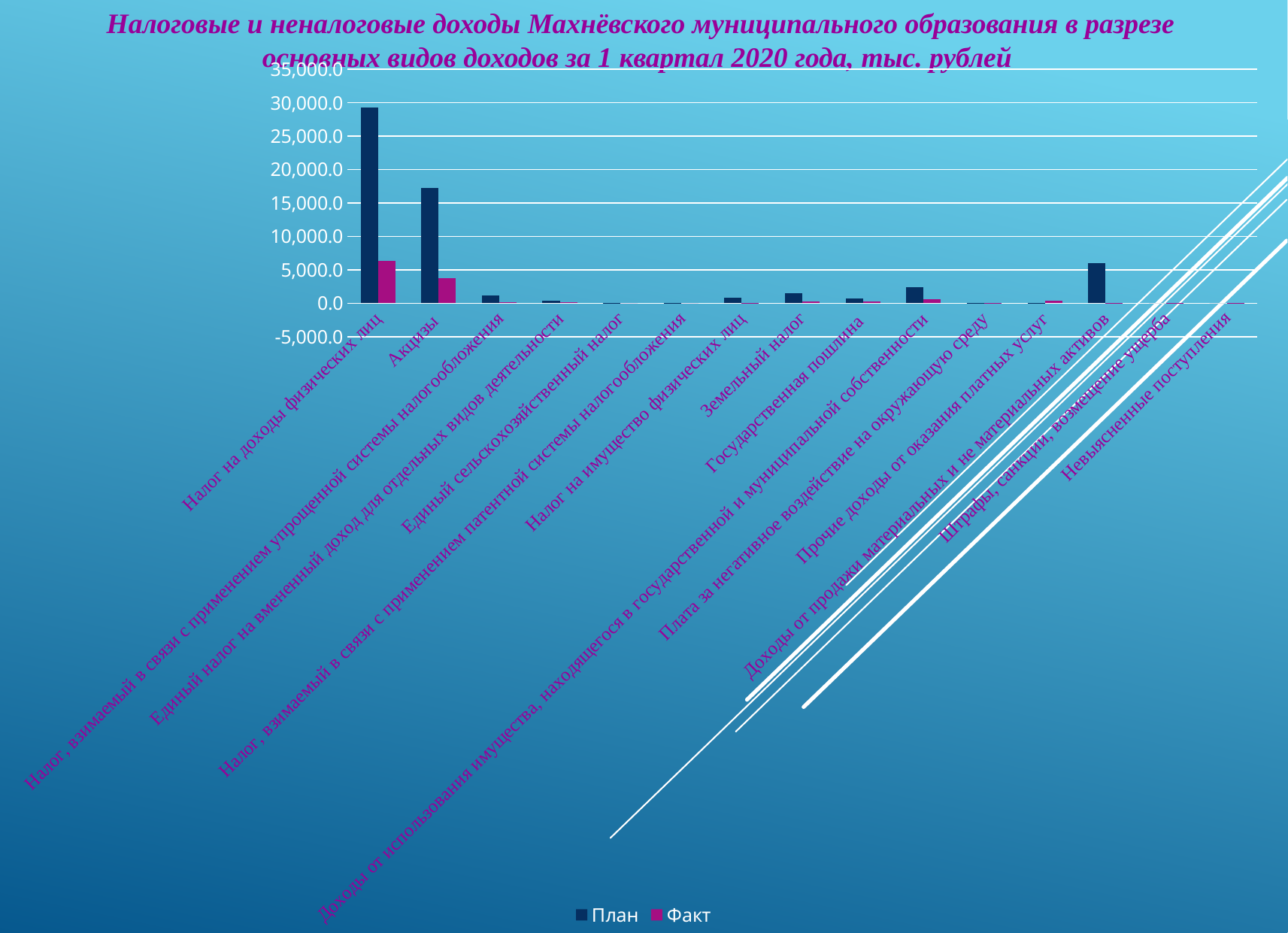
Which has the larger План value: Акцизы or Доходы от продажи материальных и не материальных активов? Акцизы How many series does the legend list? 2 Is the Факт value for Налог на доходы физических лиц greater or less than 5,000.0? greater What are the names of the two series in the legend? План and Факт How many categories are shown on the x axis? 15 Which category has the highest Факт value? Налог на доходы физических лиц Is the План value for Акцизы greater or less than 20,000.0? less Which category has the highest План value? Налог на доходы физических лиц Is the План value for Налог на доходы физических лиц greater or less than 25,000.0? greater For Налог на доходы физических лиц, which is larger: План or Факт? План What kind of chart is shown on the slide? bar chart